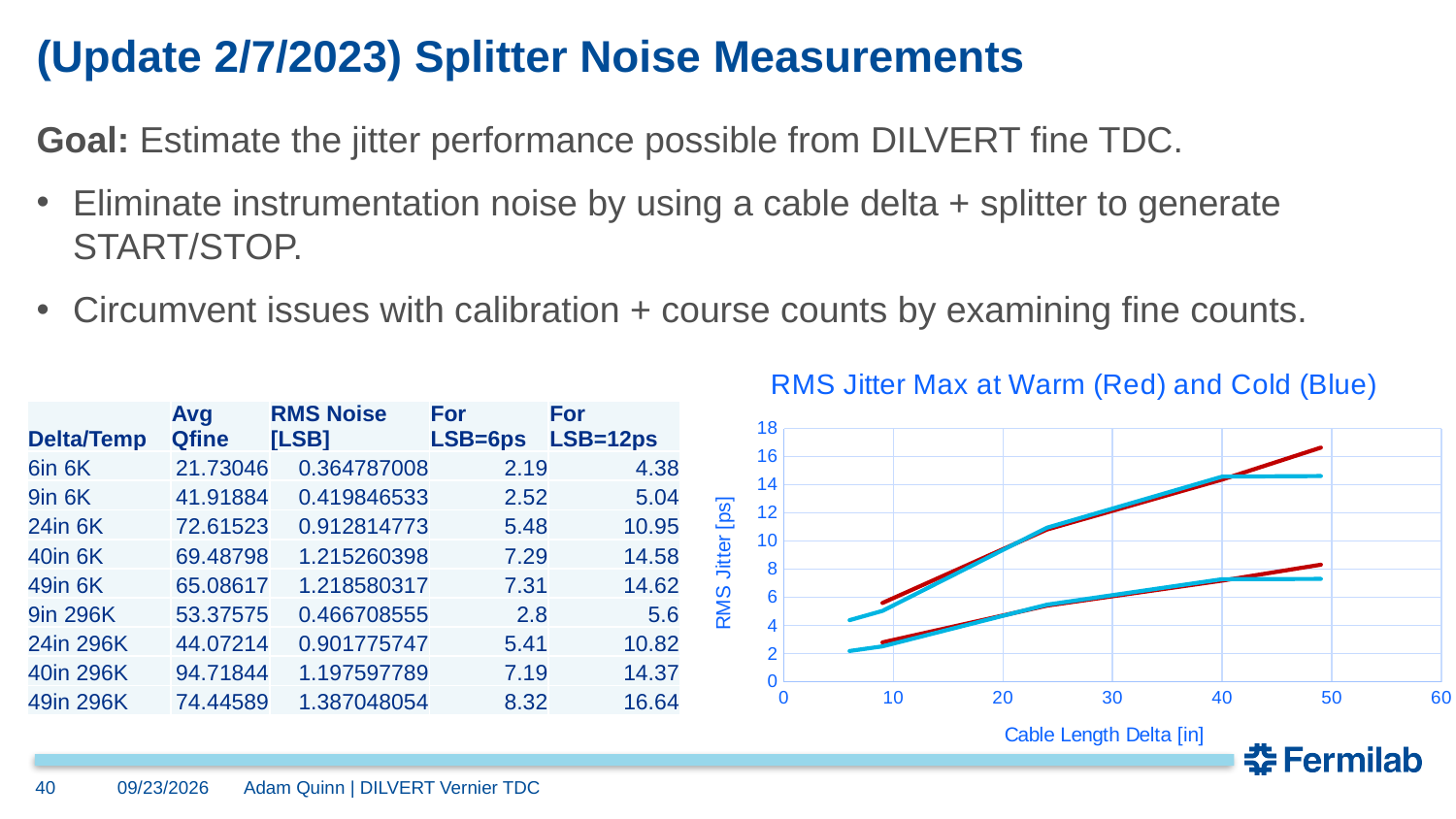
Is the value of the lower red line at a cable length delta of 49 in greater or less than 10? less Is the value of the upper red line at a cable length delta of 24 in greater or less than 8? greater What kind of chart is shown on the slide? line chart Is the value of the upper red line at a cable length delta of 49 in greater or less than 14? greater How many lines are plotted on the chart? 4 At a cable length delta of 49 in, which of the two upper lines is higher, the red one or the blue one? red Do the plotted RMS jitter values rise or fall as the cable length delta increases? rise What is the title of the chart? RMS Jitter Max at Warm (Red) and Cold (Blue) What is the label of the x axis of the chart? Cable Length Delta [in]